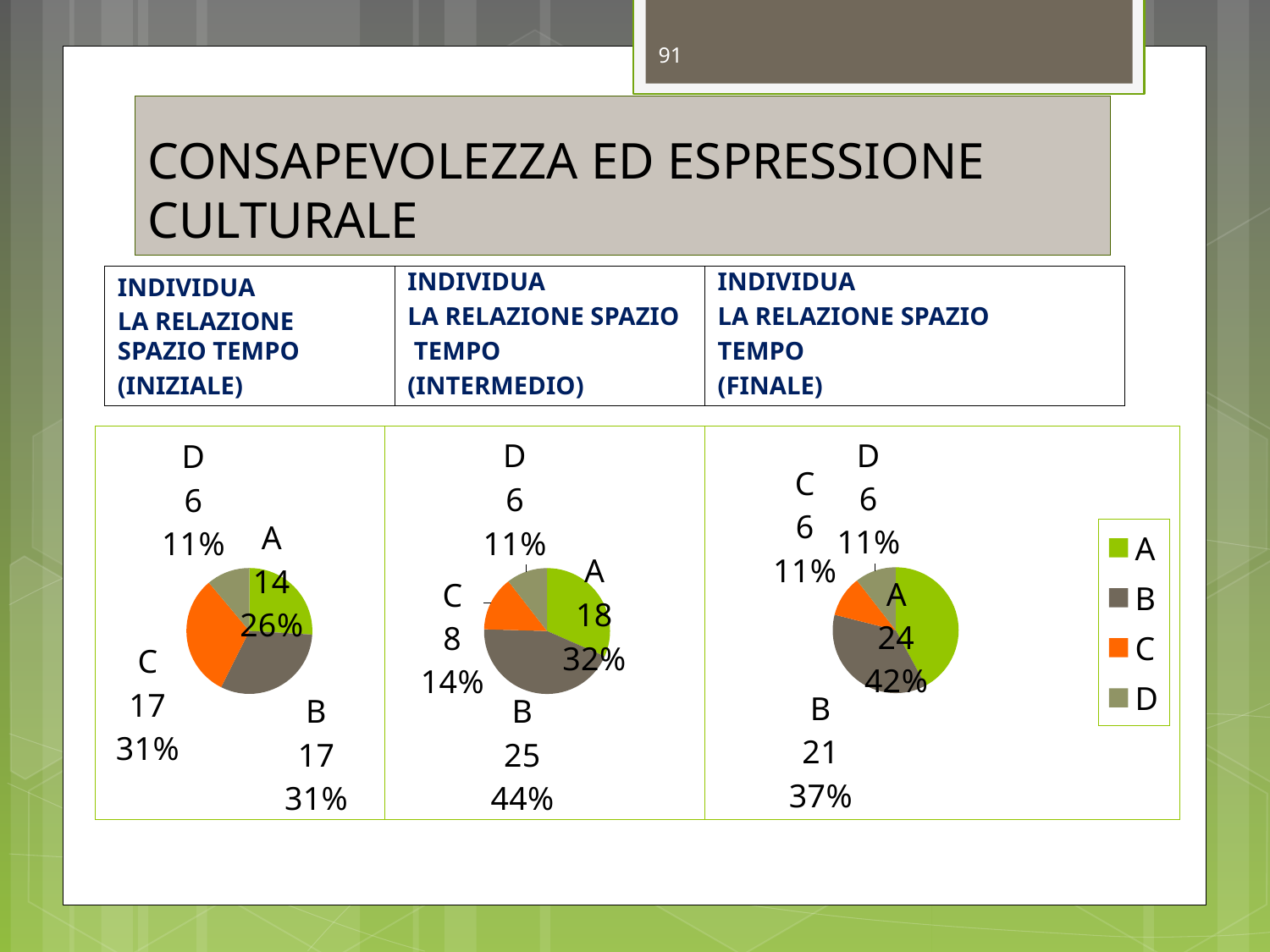
In the left pie chart (INIZIALE), what is the value for category A? 14 In the middle pie chart (INTERMEDIO), which is larger, the value for A or the value for C? A In the right pie chart (FINALE), which category has the largest slice? A In the left pie chart (INIZIALE), what share of the pie does category C represent? 31% In the middle pie chart (INTERMEDIO), what is the value for category B? 25 In the right pie chart (FINALE), what is the value for category A? 24 In the middle pie chart (INTERMEDIO), what share of the pie does category C represent? 14% What kind of chart is used for the INTERMEDIO data? Pie chart How many entries does the legend on the slide list? 4 In the middle pie chart (INTERMEDIO), which category has the largest slice? B How many slices does the left pie chart (INIZIALE) have? 4 In the right pie chart (FINALE), what is the difference between the values for A and B? 3